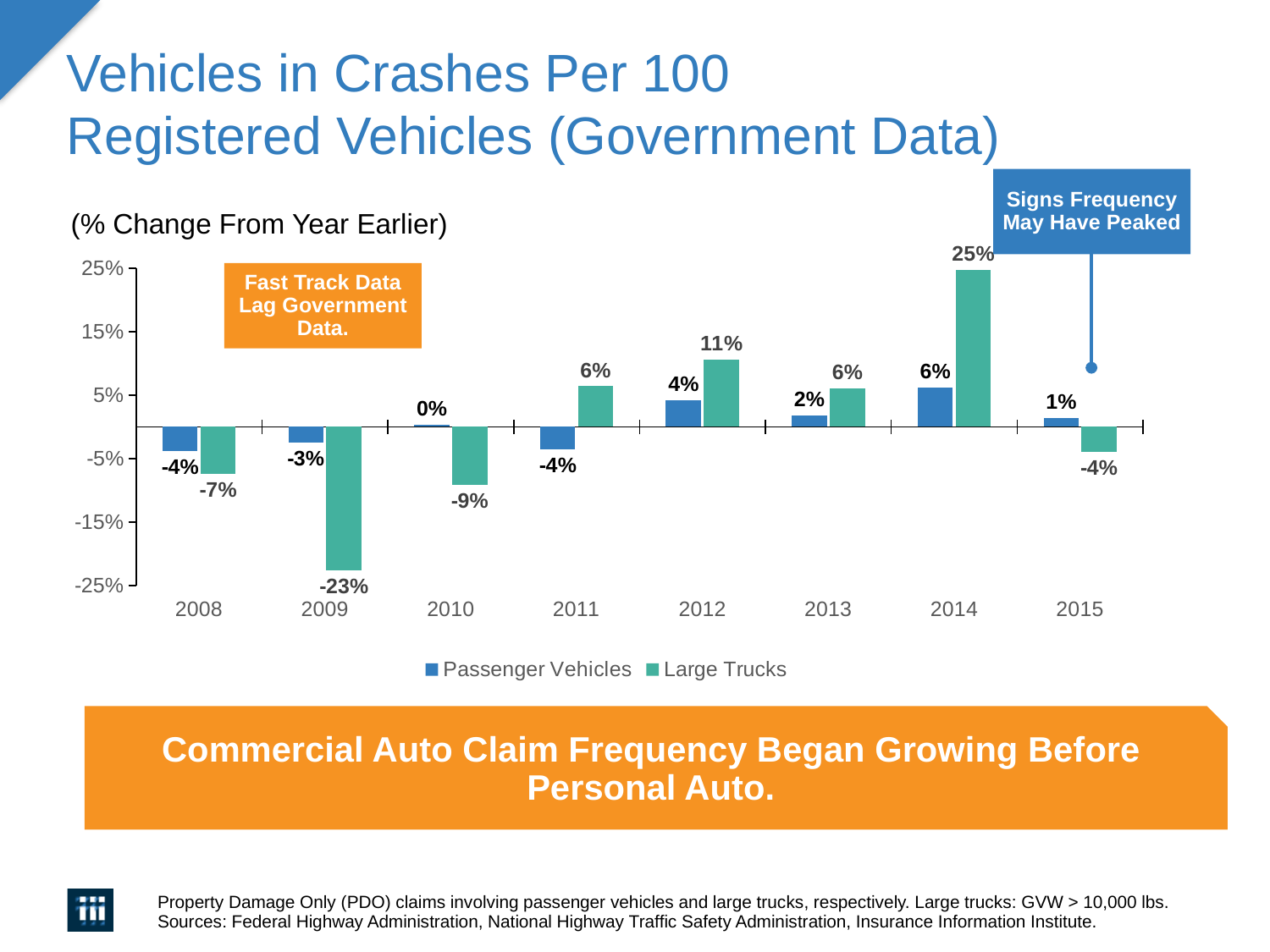
How many series does the legend list? 2 In which year is the Large Trucks value lowest? 2009 What is the value for Passenger Vehicles in 2009? -3% What is the value for Large Trucks in 2010? -9% What is the value for Passenger Vehicles in 2012? 4% What is the difference between the Large Trucks and Passenger Vehicles values in 2014? 19 percentage points Which colour represents Large Trucks in the chart? Teal (green) What kind of chart is shown on the slide? Bar chart How many years are shown on the x axis? 8 In which year is the Passenger Vehicles value highest? 2014 In 2015, which series has the larger value, Passenger Vehicles or Large Trucks? Passenger Vehicles What is the value for Large Trucks in 2014? 25%